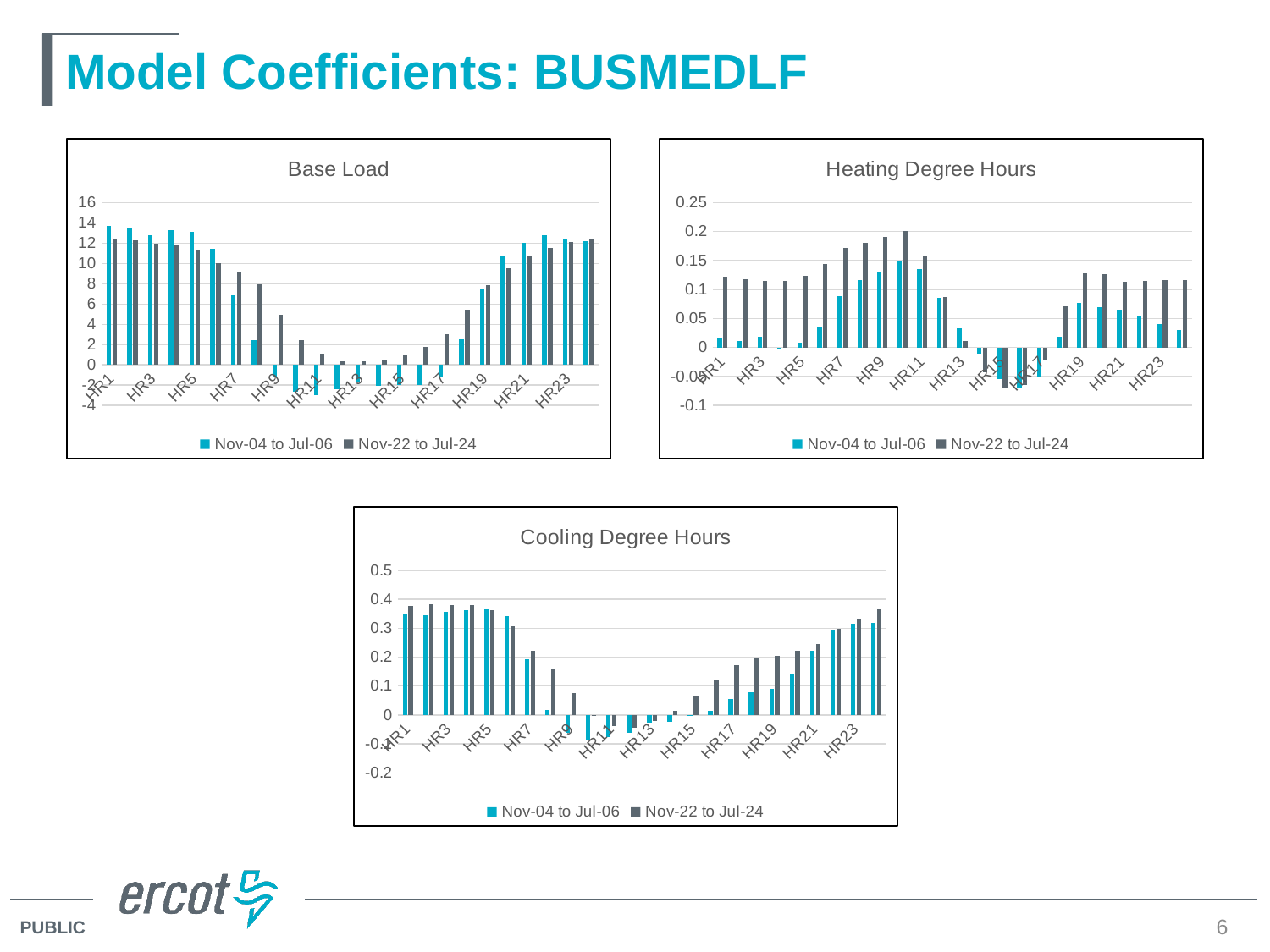
In the Heating Degree Hours chart, which series has the larger value at HR10, Nov-04 to Jul-06 or Nov-22 to Jul-24? Nov-22 to Jul-24 In the Heating Degree Hours chart, is the value for HR10 in the Nov-22 to Jul-24 series greater or less than 0.15? greater What kind of chart is the Base Load chart? bar chart How many charts are shown on the slide? 3 What are the two legend entries on the Cooling Degree Hours chart? Nov-04 to Jul-06 and Nov-22 to Jul-24 In the Cooling Degree Hours chart, is the value for HR3 in the Nov-22 to Jul-24 series greater or less than 0.3? greater In the Base Load chart, is the value for HR11 in the Nov-04 to Jul-06 series greater or less than 0? less In the Cooling Degree Hours chart, do the Nov-22 to Jul-24 values generally rise or fall from HR15 to HR23? rise In the Base Load chart, which series has the larger value at HR1, Nov-04 to Jul-06 or Nov-22 to Jul-24? Nov-04 to Jul-06 How many series does the legend of the Heating Degree Hours chart list? 2